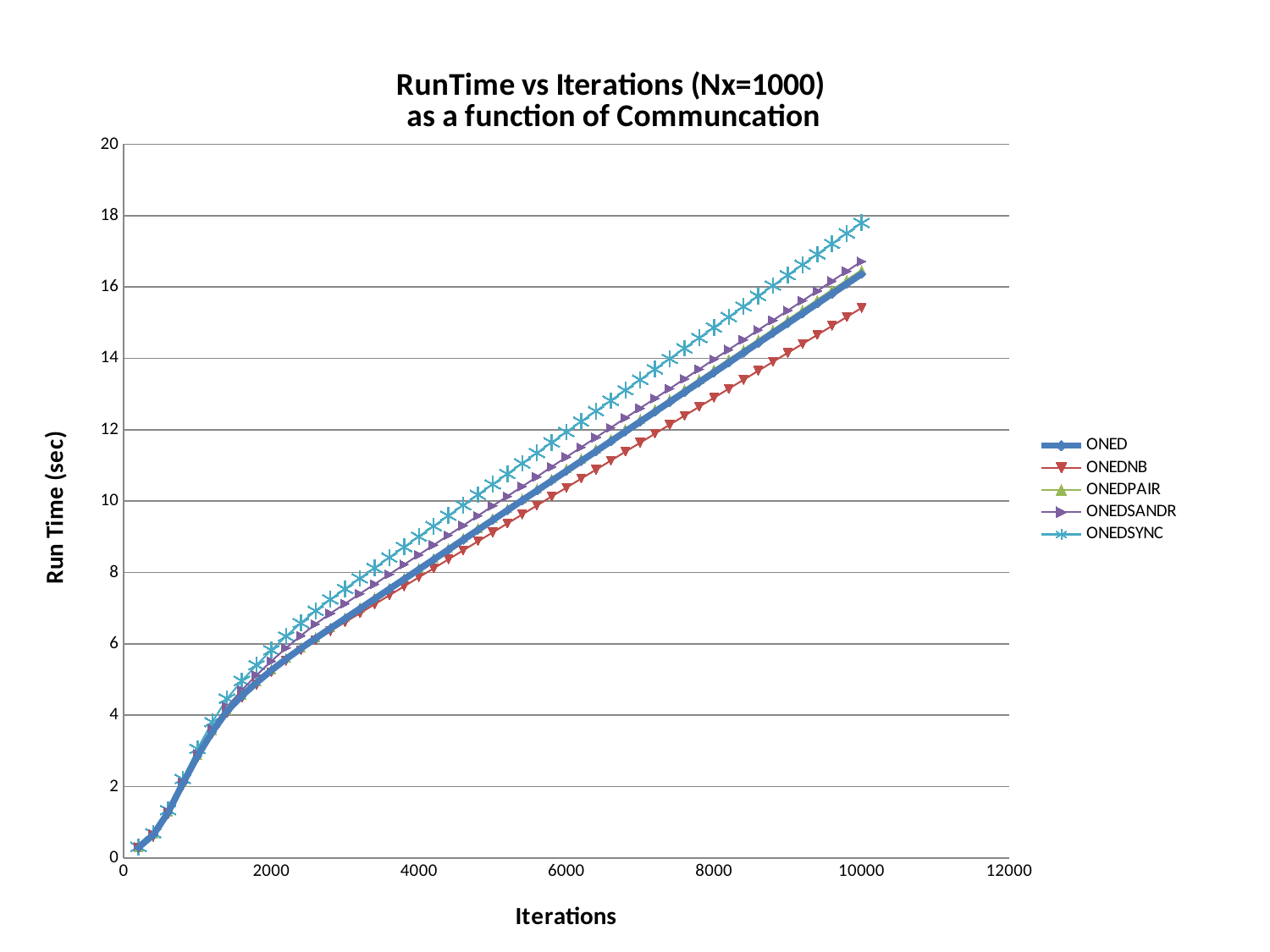
Which series has the lowest run time at 10000 iterations? ONEDNB How many series does the legend list? 5 Is the run time for ONEDSYNC at 10000 iterations greater or less than 16 seconds? greater What is the title of the chart? RunTime vs Iterations (Nx=1000) as a function of Communcation At 10000 iterations, which series has the larger run time, ONEDSYNC or ONEDNB? ONEDSYNC Is the run time for ONED at 2000 iterations greater or less than 4 seconds? greater What is the label of the vertical axis? Run Time (sec) Do the run times rise or fall as the number of iterations increases? rise Is the run time for ONEDNB at 10000 iterations greater or less than 16 seconds? less What kind of chart is shown on the slide? line chart Which series has the highest run time at 10000 iterations? ONEDSYNC